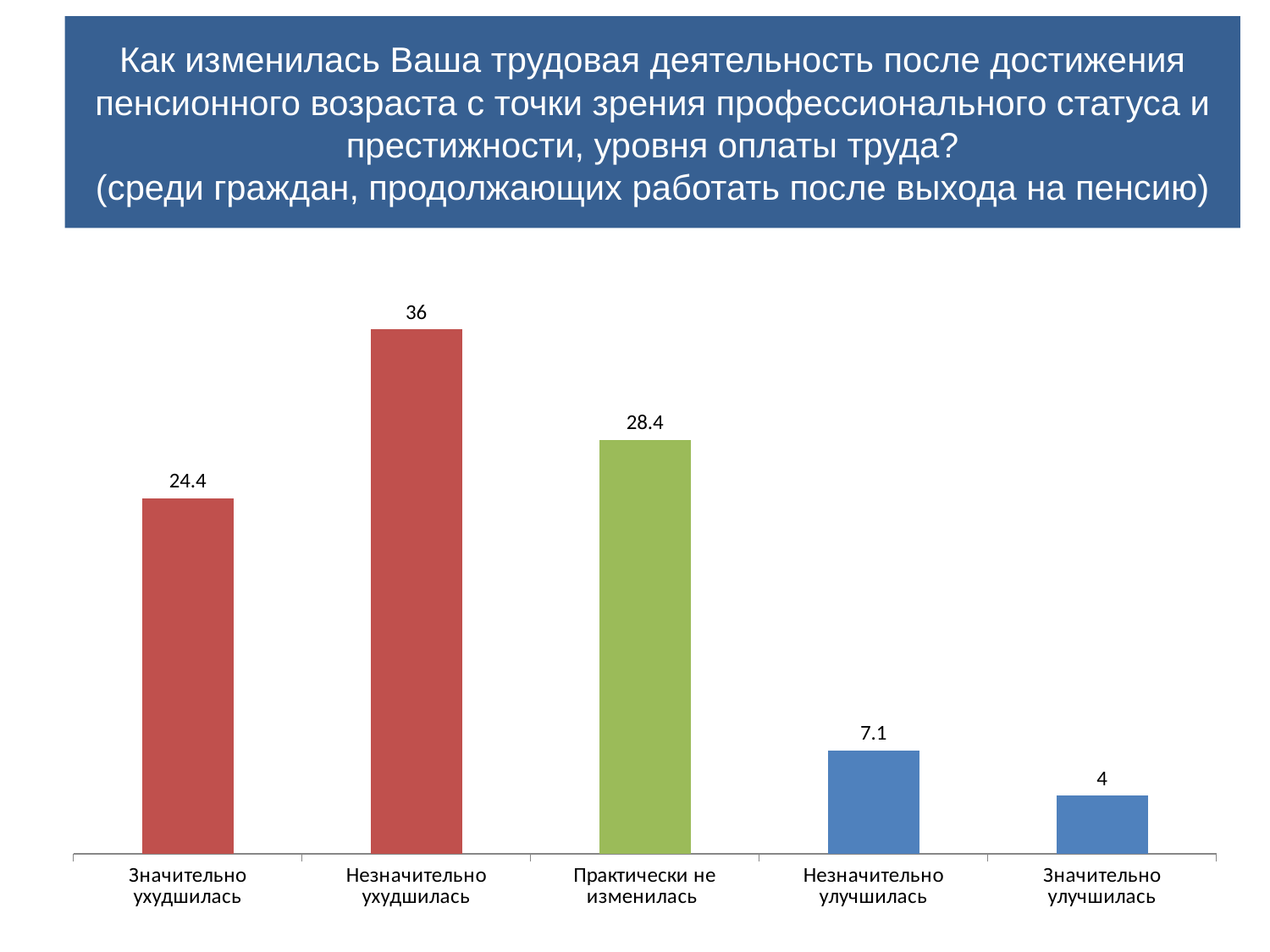
What is the total of the values for "Незначительно улучшилась" and "Значительно улучшилась"? 11.1 Which is larger: the value for "Практически не изменилась" or the value for "Значительно ухудшилась"? Практически не изменилась What is the value for "Практически не изменилась"? 28.4 Which category has the highest value? Незначительно ухудшилась What is the value for "Незначительно улучшилась"? 7.1 How many categories are shown on the chart? 5 What is the value for "Незначительно ухудшилась"? 36 What is the value for "Значительно улучшилась"? 4 What kind of chart is shown on the slide? Bar chart Which category has the lowest value? Значительно улучшилась What colour is the bar for "Практически не изменилась"? Green What is the difference between the values for "Незначительно ухудшилась" and "Значительно ухудшилась"? 11.6